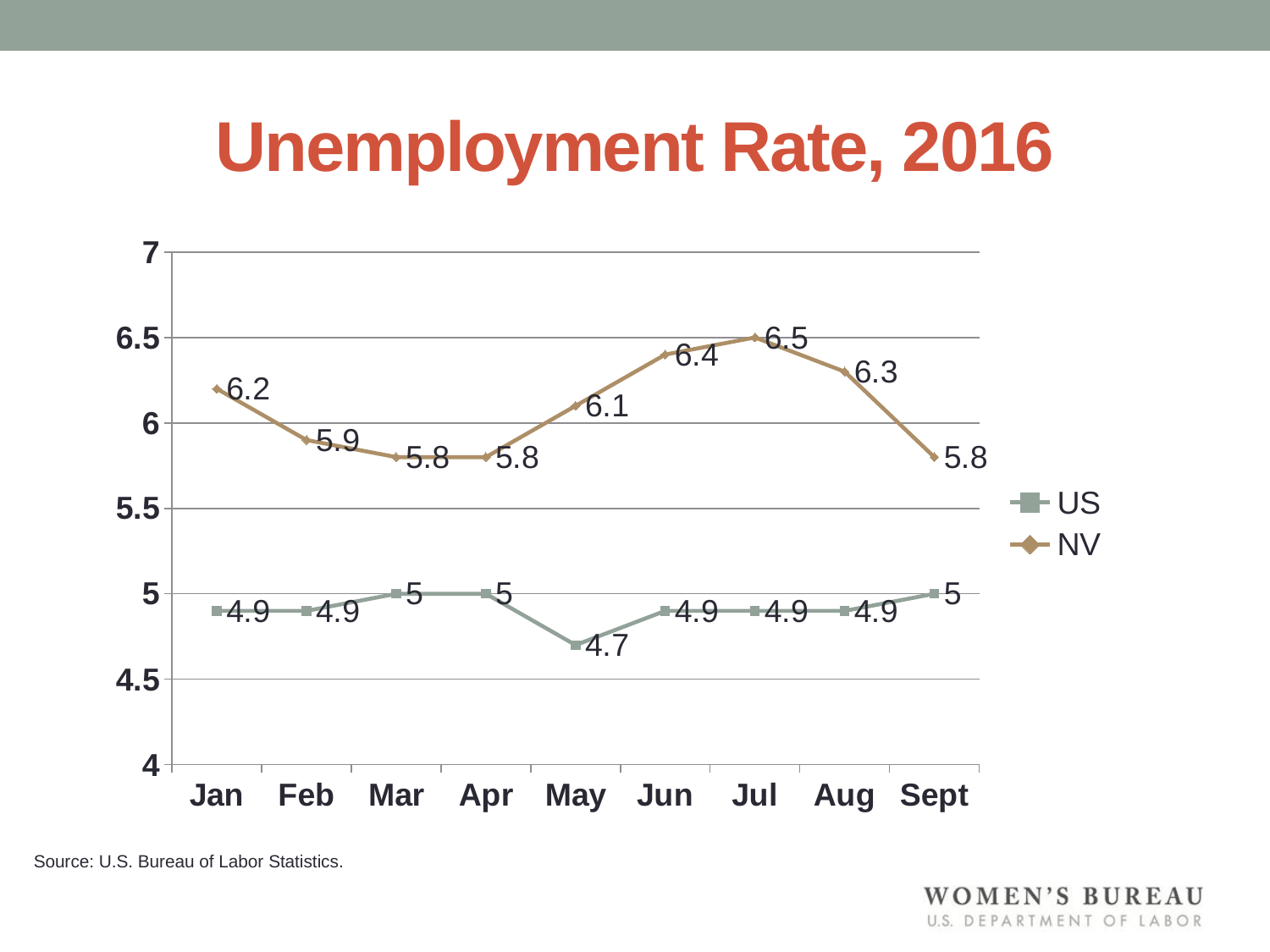
How many series does the legend list? 2 In which month is the US unemployment rate lowest? May What is the NV unemployment rate in Jul? 6.5 What is the US unemployment rate in May? 4.7 What is the NV unemployment rate in Jan? 6.2 Which is larger, the NV rate in Jun or the NV rate in Aug? NV rate in Jun What is the difference between the NV and US unemployment rates in Jul? 1.6 In which month is the NV unemployment rate highest? Jul Is the NV unemployment rate in Jul greater or less than 6? greater What kind of chart is shown on the slide? Line chart How many months are shown on the x axis? 9 What is the difference between the NV rate in Jan and the NV rate in Mar? 0.4